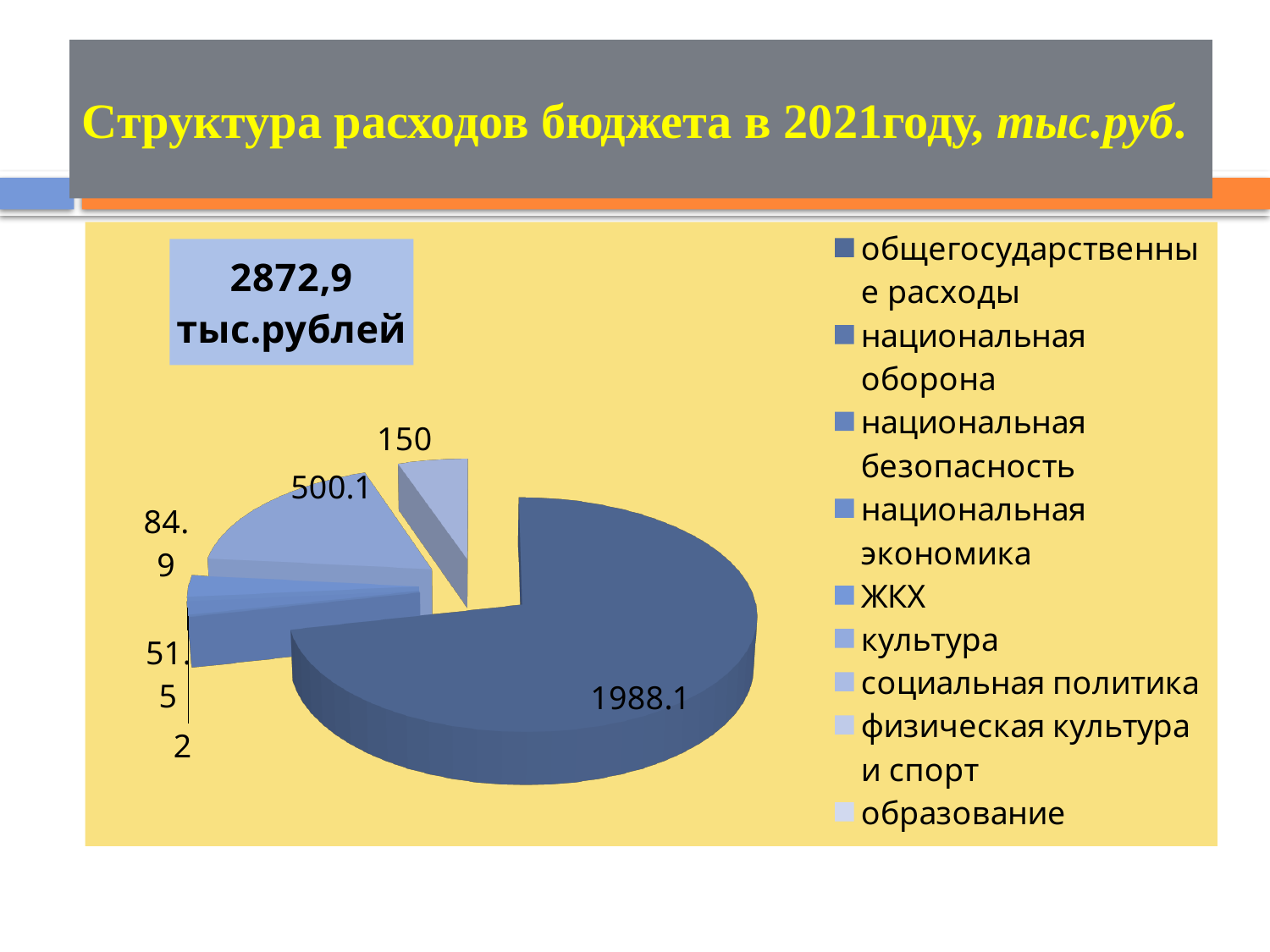
Which legend category corresponds to the largest slice of the pie chart? общегосударственные расходы What is the value of the largest slice of the pie chart? 1988.1 What total amount is shown in the box above the pie chart? 2872,9 тыс.рублей What is the smallest value printed as a data label on the pie chart? 2 How many categories does the legend of the pie chart list? 9 Which is larger, the slice labelled 500.1 or the slice labelled 150? 500.1 How many data labels are printed on the pie chart? 6 What is the difference between the slice labelled 500.1 and the slice labelled 150? 350.1 What kind of chart is shown on the slide? pie chart What is the difference between the slice labelled 84.9 and the slice labelled 51.5? 33.4 What is the title of the slide with the pie chart? Структура расходов бюджета в 2021году, тыс.руб.